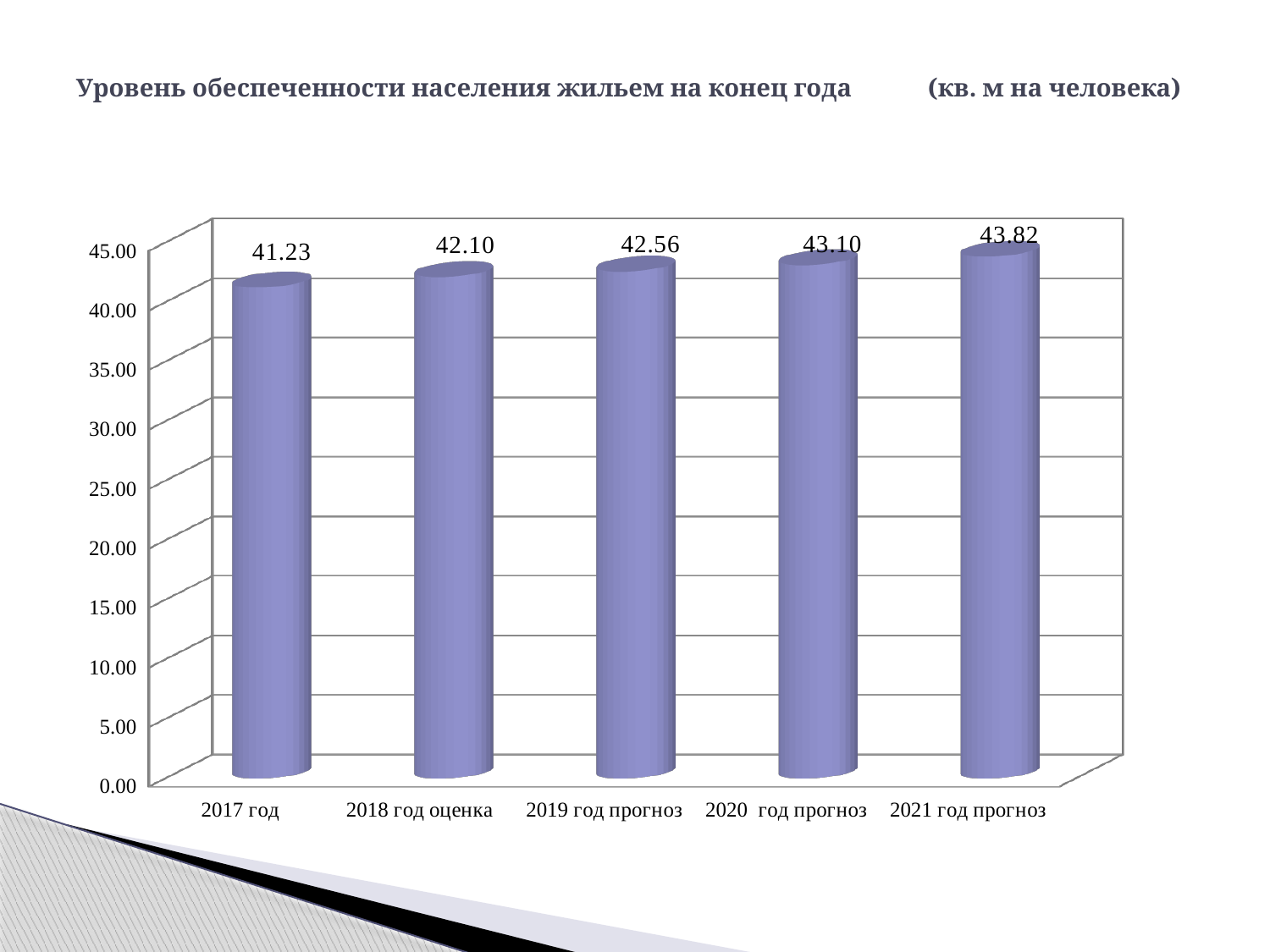
What is the value for 2021 год прогноз? 43.82 What is the difference between the values for 2021 год прогноз and 2017 год? 2.59 Which category has the highest value? 2021 год прогноз What is the value for 2017 год? 41.23 Which category has the lowest value? 2017 год What kind of chart is shown on the slide? bar chart Is the value for 2019 год прогноз greater or less than 40.00? greater What is the value for 2019 год прогноз? 42.56 How many categories are shown on the x axis? 5 Do the values rise or fall from 2017 год to 2021 год прогноз? rise What is the difference between the values for 2020 год прогноз and 2018 год оценка? 1.00 Which is larger, the value for 2018 год оценка or the value for 2020 год прогноз? 2020 год прогноз